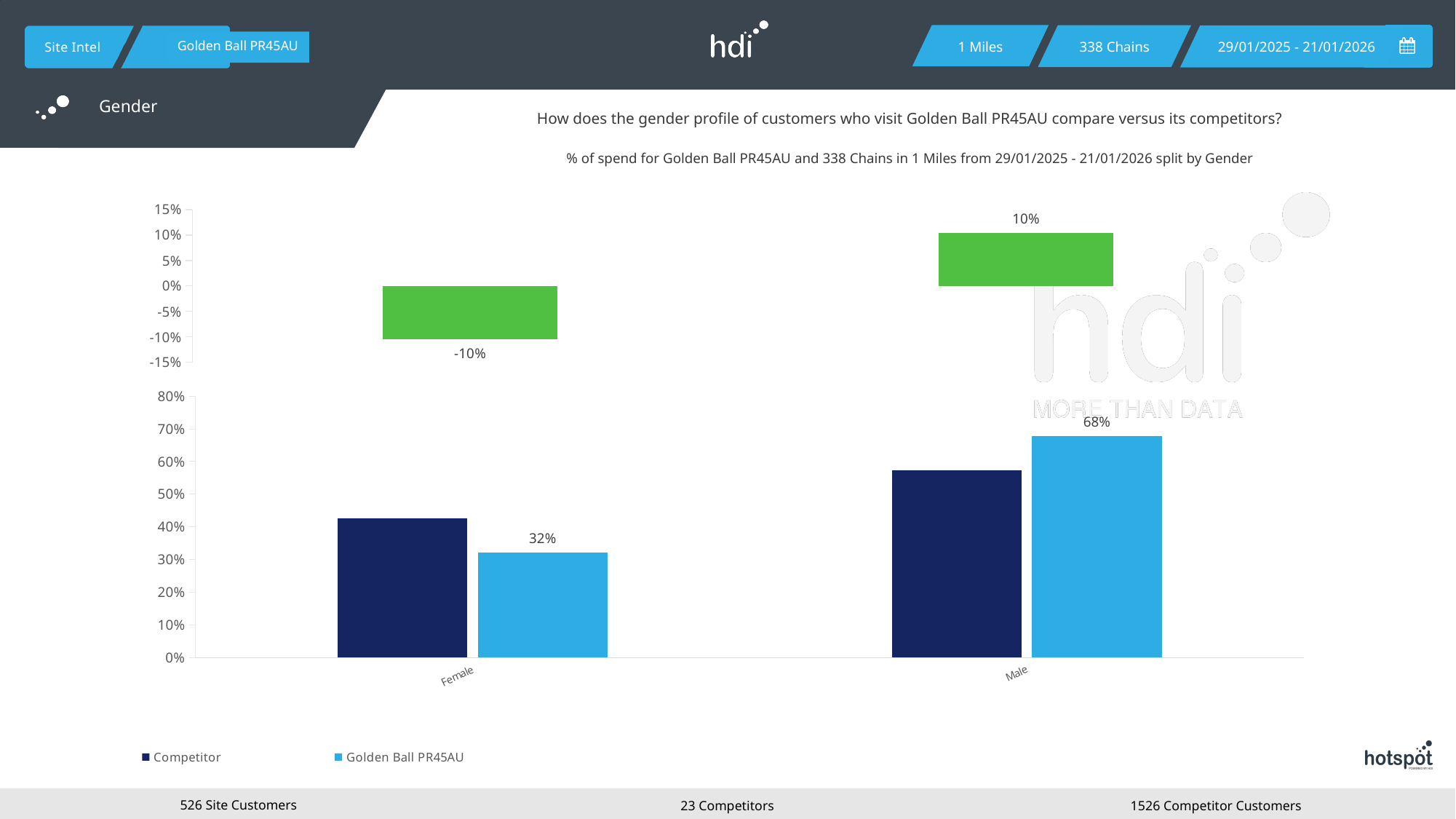
In the top chart, what is the value shown for Female? -10% In the bottom bar chart, what is the value for Golden Ball PR45AU for Female? 32% How many categories are shown on the x axis of the bottom chart? 2 In the bottom bar chart, which is larger for Male: Competitor or Golden Ball PR45AU? Golden Ball PR45AU In the bottom bar chart, what is the difference between the Golden Ball PR45AU values for Male and Female? 36% In the bottom bar chart, is the Competitor value for Male greater or less than 50%? greater In the top chart, what is the value shown for Male? 10% How many series does the legend of the bottom chart list? 2 What kind of chart is the bottom chart? Bar chart In the bottom bar chart, what is the value for Golden Ball PR45AU for Male? 68% In the bottom bar chart, which is larger for Female: Competitor or Golden Ball PR45AU? Competitor In the bottom bar chart, is the Competitor value for Female greater or less than 50%? less